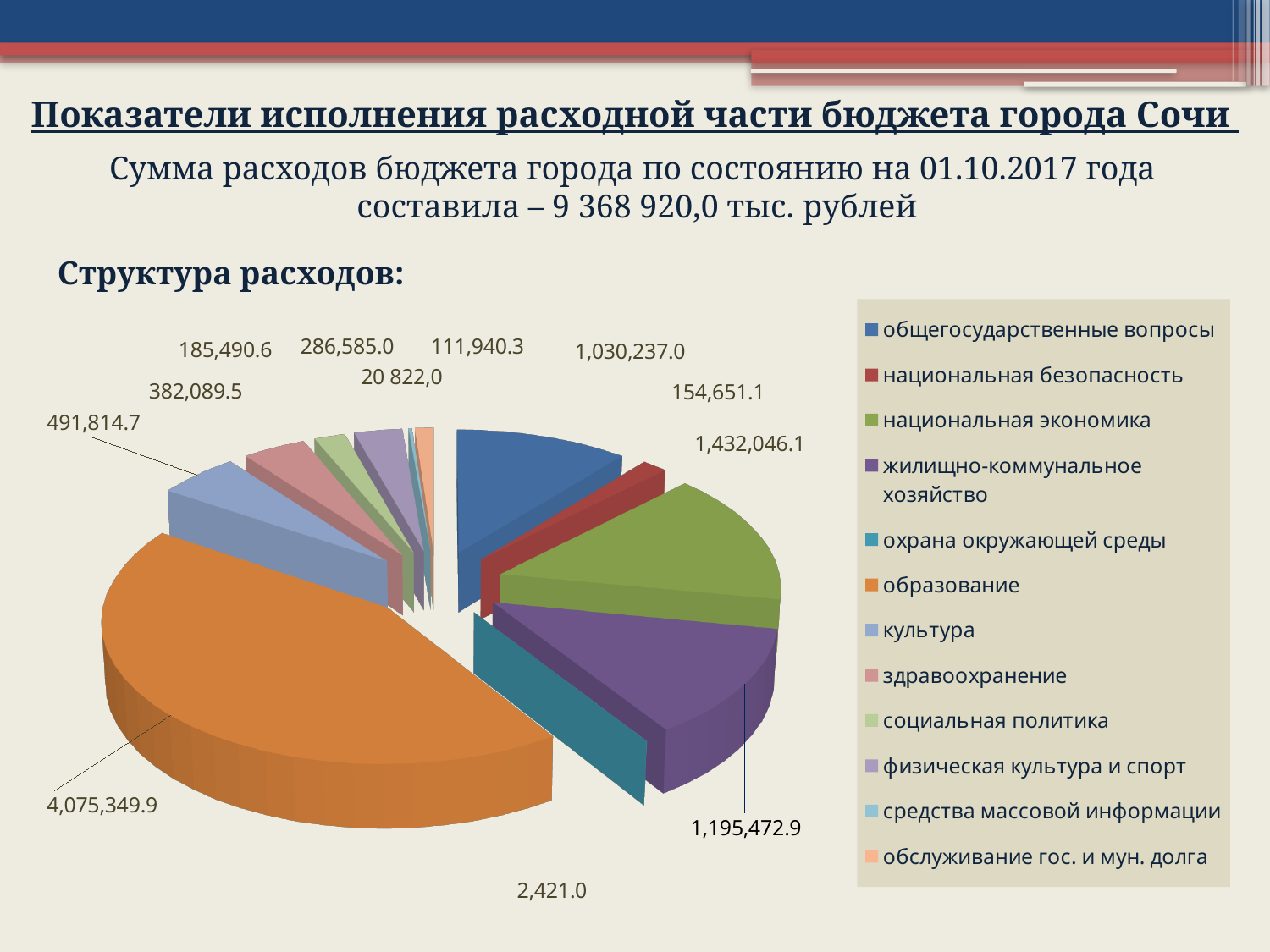
What kind of chart is shown on the slide? pie chart How many categories does the legend of the pie chart list? 12 What is the heading printed above the pie chart? Структура расходов: What is the value shown for культура? 491,814.7 Which is larger, the slice for образование or the slice for национальная экономика? образование Which category has the largest slice in the pie chart? образование Which colour represents образование in the pie chart? orange What is the difference between the values for национальная экономика and жилищно-коммунальное хозяйство? 236,573.2 What is the value shown for общегосударственные вопросы? 1,030,237.0 What is the value shown for образование? 4,075,349.9 What is the value shown for жилищно-коммунальное хозяйство? 1,195,472.9 What is the value shown for национальная экономика? 1,432,046.1